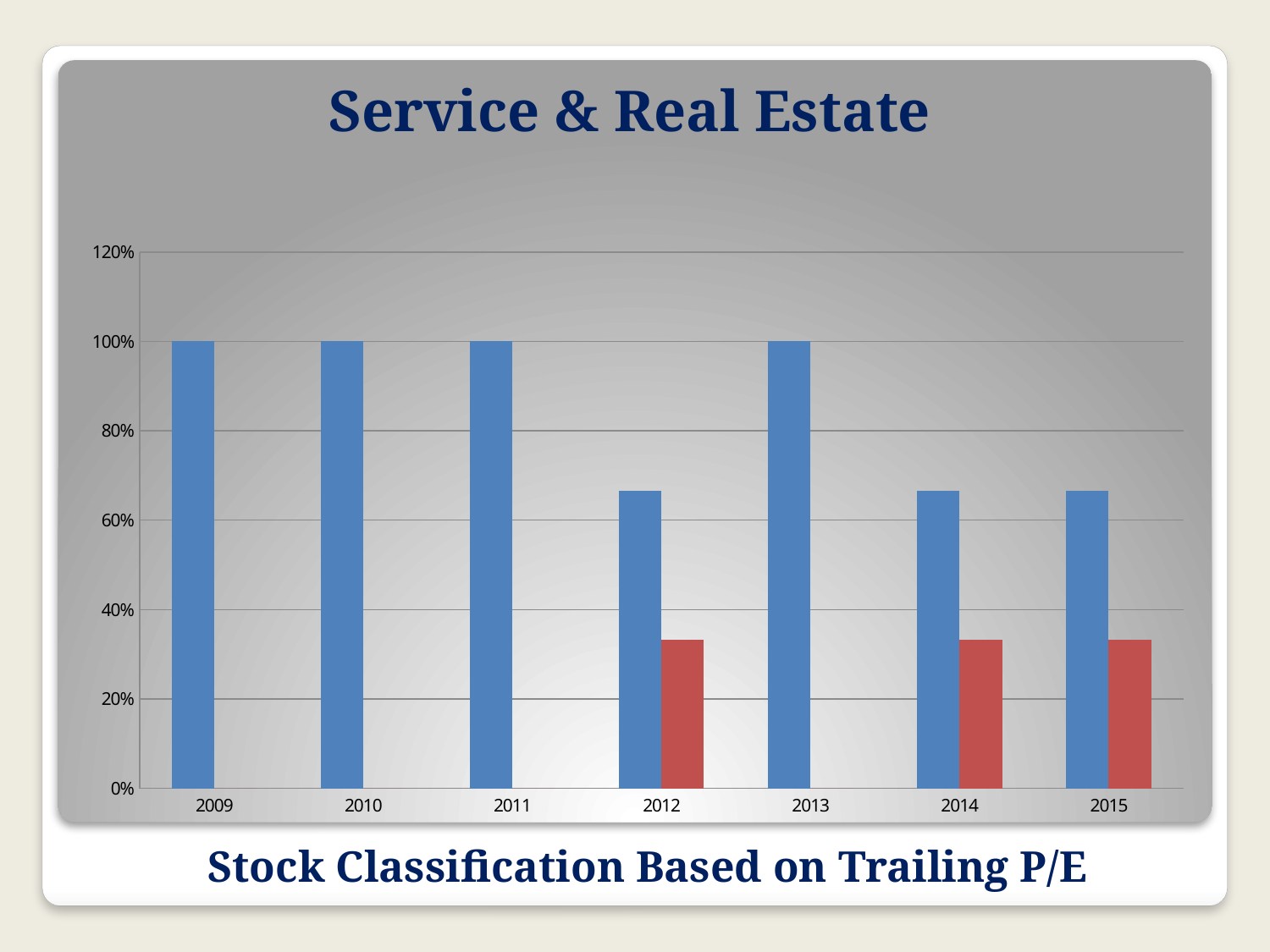
What is the title of the chart? Service & Real Estate What is the value of the blue bar for 2013? 100% How many years are shown on the x axis? 7 What is the caption below the chart? Stock Classification Based on Trailing P/E Is the value of the blue bar for 2012 greater or less than 80%? less Is the value of the red bar for 2014 greater or less than 40%? less How many years have a red bar? 3 What kind of chart is shown on the slide? bar chart Is the value of the blue bar for 2015 greater or less than 60%? greater What is the value of the blue bar for 2009? 100% Which is larger, the blue bar for 2011 or the blue bar for 2014? 2011 Which is larger in 2012, the blue bar or the red bar? the blue bar